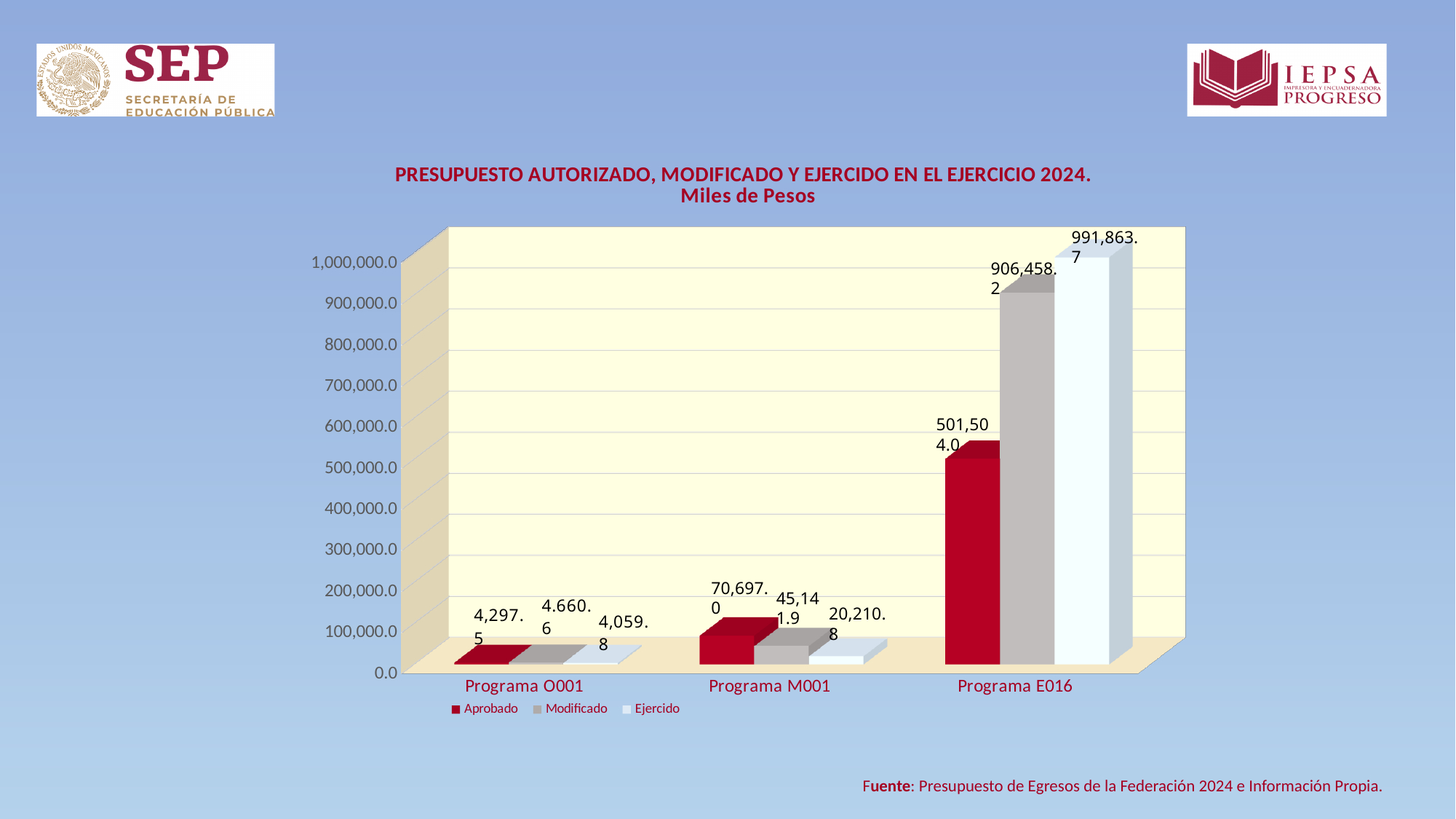
What is the Aprobado value for Programa O001? 4,297.5 Which program has the highest Ejercido value? Programa E016 What is the difference between the Ejercido and Modificado values for Programa E016? 85,405.5 How many series does the legend list? 3 What is the Aprobado value for Programa E016? 501,504.0 What is the Modificado value for Programa M001? 45,141.9 What kind of chart is shown on the slide? Bar chart What is the Ejercido value for Programa E016? 991,863.7 Is the Modificado value for Programa E016 greater or less than 900,000.0? greater Which program has the lowest Aprobado value? Programa O001 For Programa M001, which is larger: the Aprobado value or the Ejercido value? Aprobado How many programs are shown on the x axis? 3